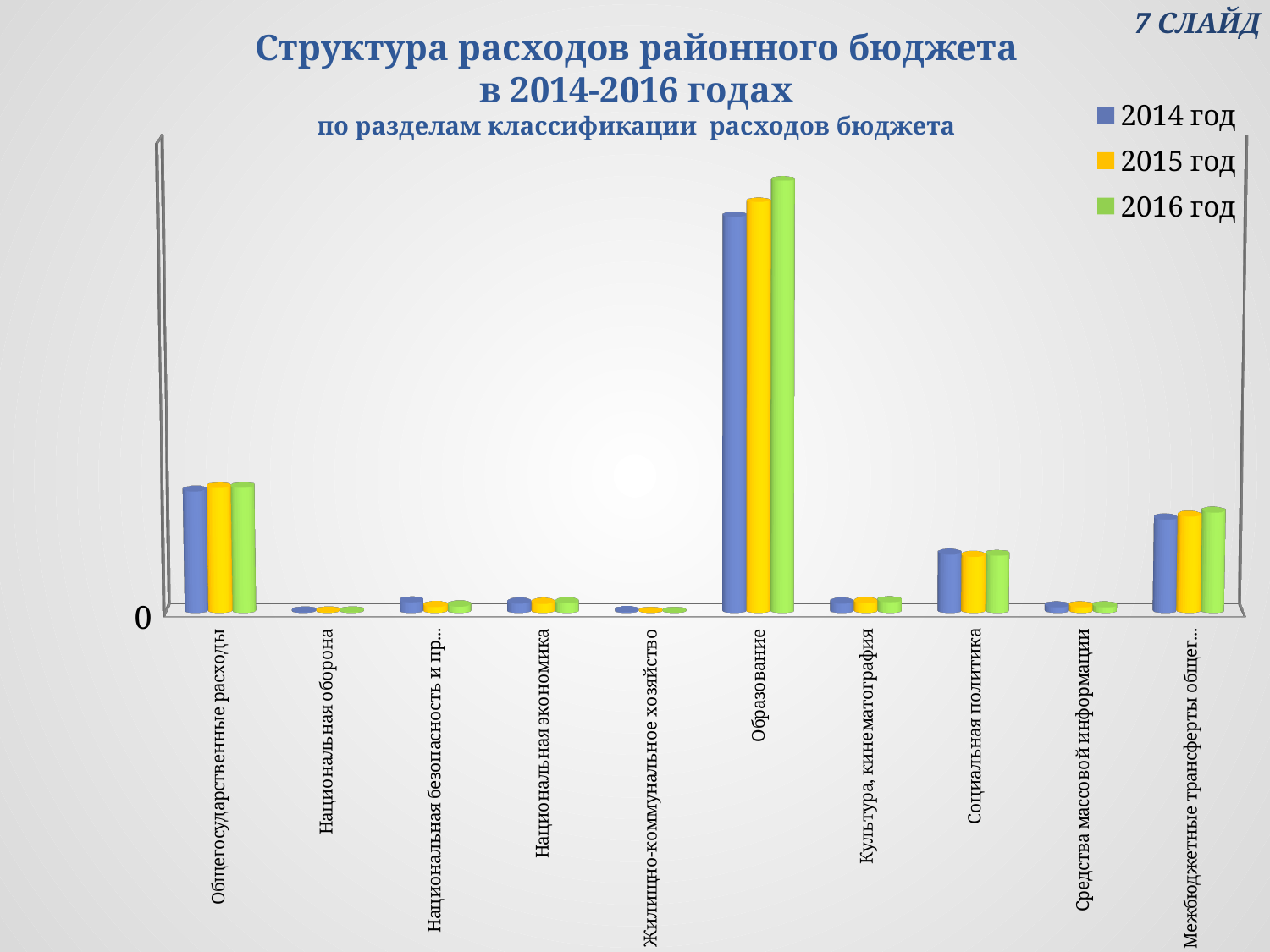
Which category has the highest values in the chart? Образование Which is larger for 2014 год: Общегосударственные расходы or Социальная политика? Общегосударственные расходы Which is larger for 2016 год: Образование or Социальная политика? Образование What is the main title of the chart? Структура расходов районного бюджета в 2014-2016 годах Which is larger for 2015 год: Межбюджетные трансферты or Национальная экономика? Межбюджетные трансферты Do the values for Образование rise or fall from 2014 год to 2016 год? Rise How many series does the legend list? 3 What kind of chart is shown on the slide? Bar chart Which year does the green series in the legend represent? 2016 год How many categories are shown along the x axis? 10 Which category has the second-highest values after Образование? Общегосударственные расходы